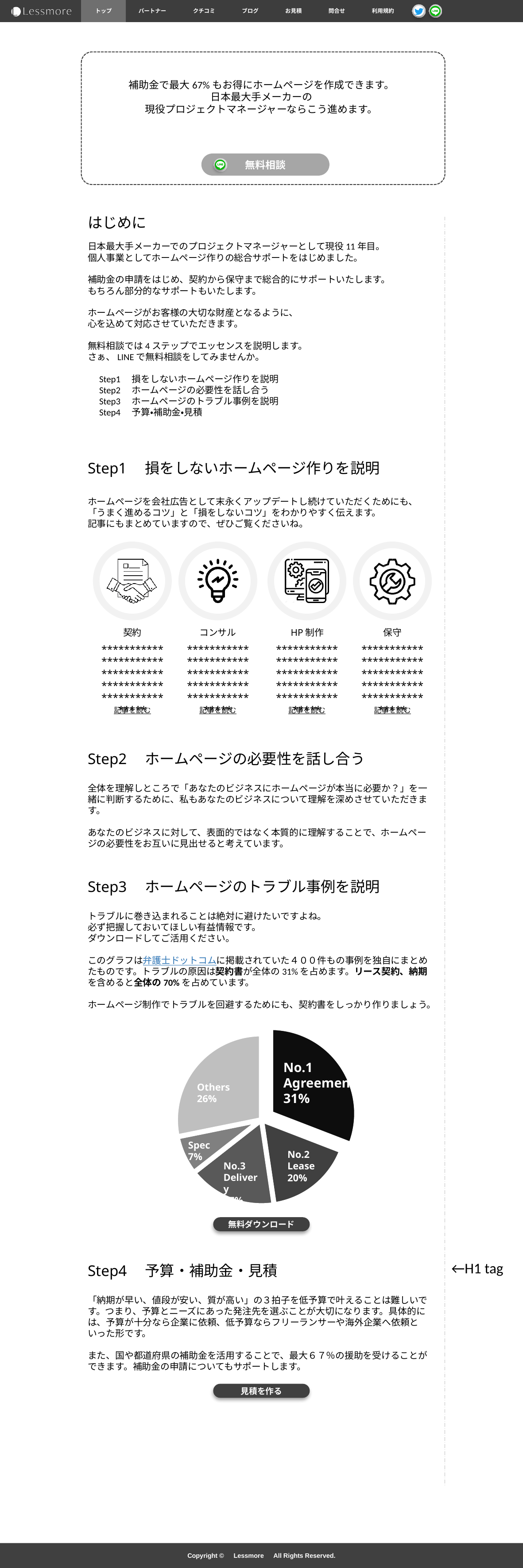
Which slice of the pie chart is the largest? No.1 Agreement In the pie chart, what is the difference between No.1 Agreement and No.2 Lease? 11% In the pie chart, what is the value for No.2 Lease? 20% How many slices does the pie chart have? 5 In the pie chart, what is the value for Spec? 7% In the pie chart, what share does the No.1 Agreement slice have? 31% In the pie chart, what is the combined share of No.1 Agreement and No.2 Lease? 51% In the pie chart, which slice is drawn in black? No.1 Agreement Which slice of the pie chart is the smallest? Spec In the pie chart, what is the value for Others? 26% In the pie chart, which is larger: Others or No.2 Lease? Others What kind of chart is shown in the Step3 section of the slide? pie chart